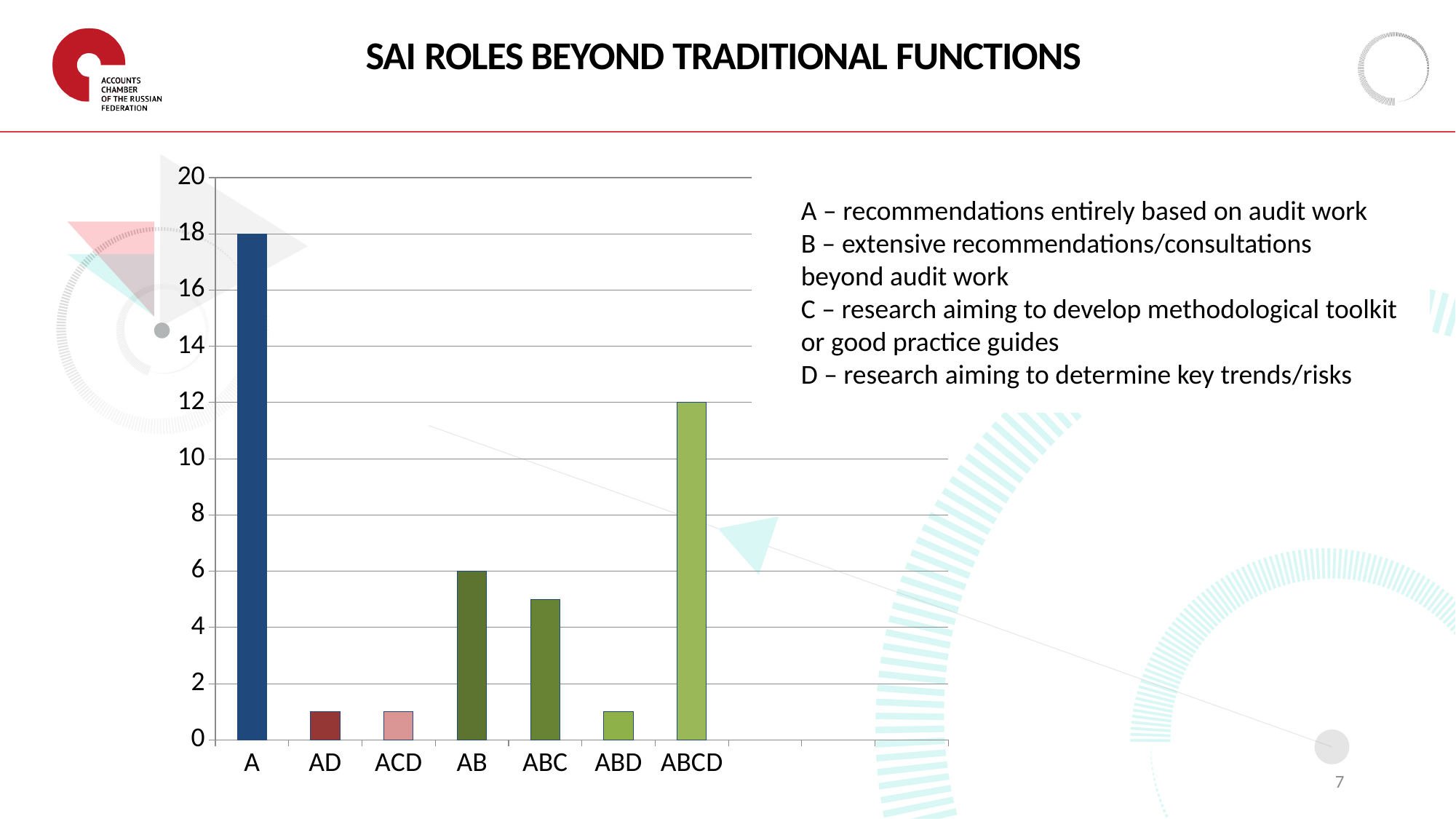
What is the value for category AB? 6 Is the value for AD greater or less than 2? less What is the value for category ABCD? 12 What is the difference between the values for ABCD and AB? 6 What is the value for category A? 18 How many categories are shown on the x axis of the chart? 7 Is the value for ABC greater or less than 4? greater What type of chart is shown on the slide? bar chart Which category has the highest value in the chart? A What is the difference between the values for A and ABCD? 6 Which is larger, the value for ABCD or the value for AB? ABCD What is the title of the slide containing the chart? SAI ROLES BEYOND TRADITIONAL FUNCTIONS